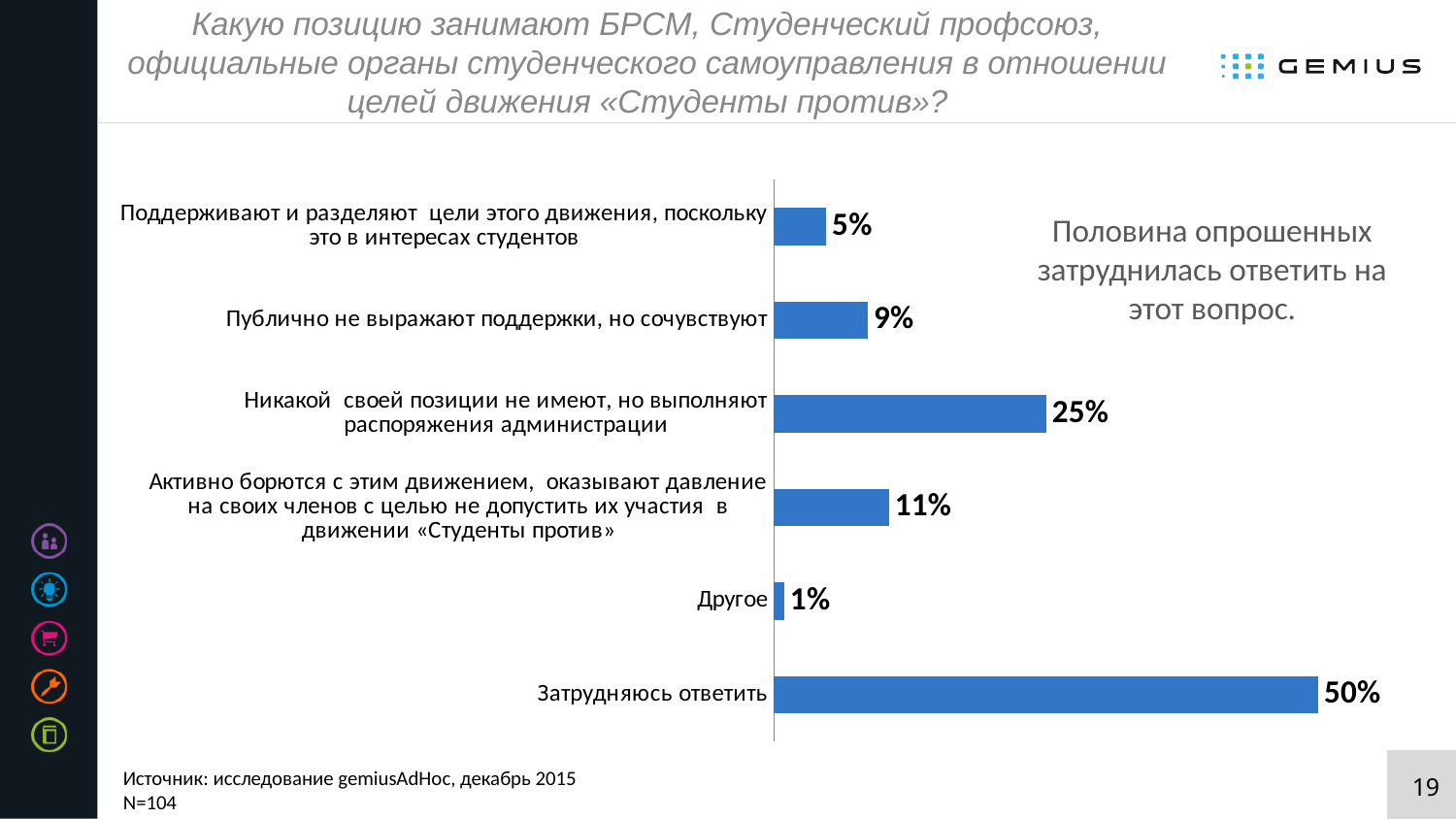
How many categories are shown in the chart? 6 Which category has the lowest value? Другое What is the value for «Публично не выражают поддержки, но сочувствуют»? 9% What is the difference between «Активно борются с этим движением...» and «Поддерживают и разделяют цели этого движения...»? 6% What is the value for «Никакой своей позиции не имеют, но выполняют распоряжения администрации»? 25% What kind of chart is shown on the slide? Bar chart What is the sample size (N) stated on the slide? N=104 What is the difference between «Затрудняюсь ответить» and «Никакой своей позиции не имеют, но выполняют распоряжения администрации»? 25% What is the value for «Другое»? 1% Which is larger: «Публично не выражают поддержки, но сочувствуют» or «Активно борются с этим движением...»? Активно борются с этим движением... What is the value for «Затрудняюсь ответить»? 50% Which category has the highest value? Затрудняюсь ответить